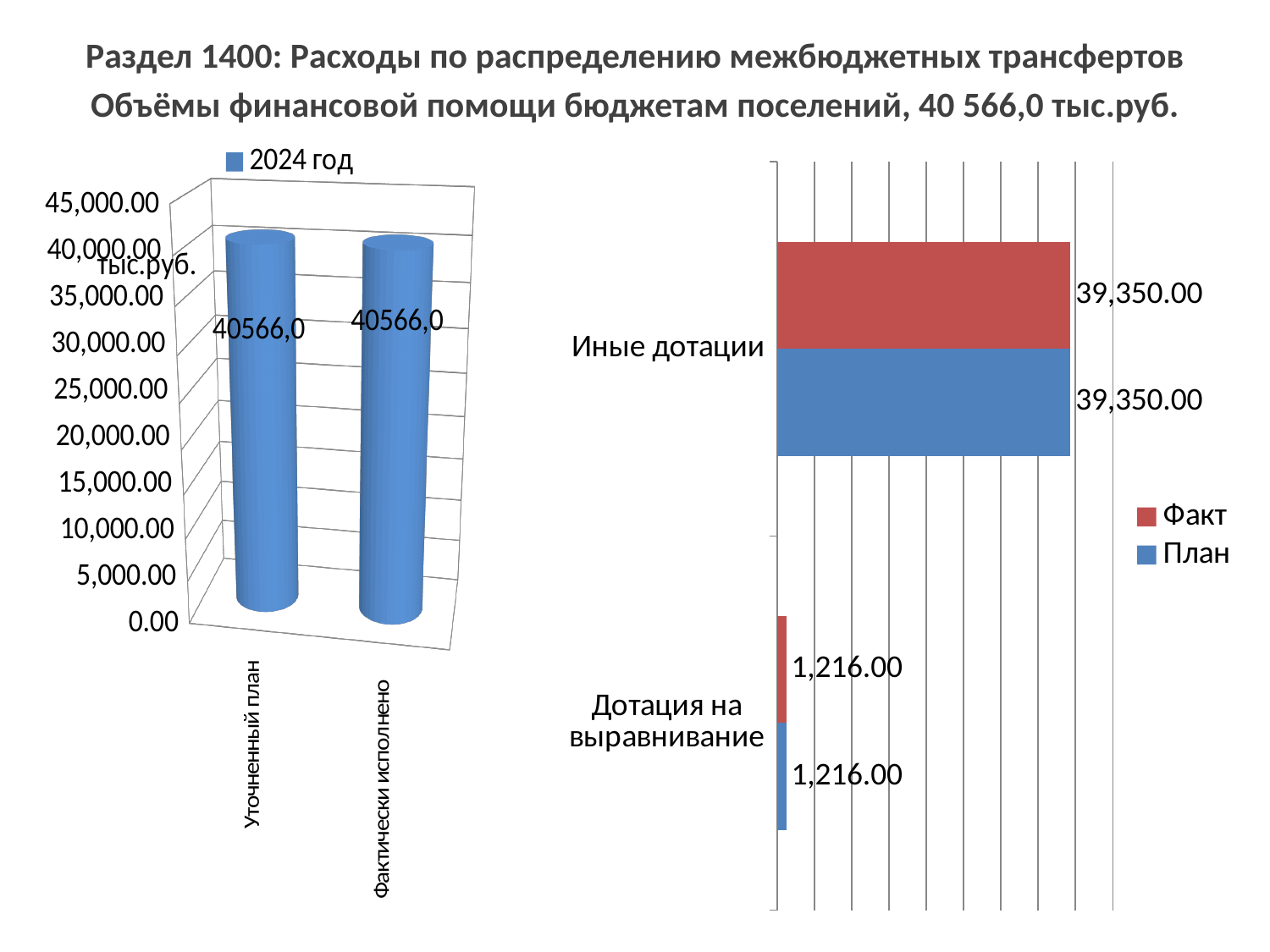
In the right chart, what is the Факт value for Дотация на выравнивание? 1,216.00 In the left chart, what is the value for Фактически исполнено? 40566,0 In the right chart, which category has the lowest План value? Дотация на выравнивание What type of chart is the right chart? bar chart In the left chart, what is the value for Уточненный план? 40566,0 In the right chart, which category has the highest Факт value? Иные дотации In the left chart, is the value for Уточненный план greater or less than 35,000.00? greater In the left chart, how many bars are plotted? 2 In the right chart, how many series does the legend list? 2 In the right chart, what is the difference between the Факт values for Иные дотации and Дотация на выравнивание? 38,134.00 In the left chart, what series does the legend list? 2024 год In the right chart, what is the План value for Иные дотации? 39,350.00